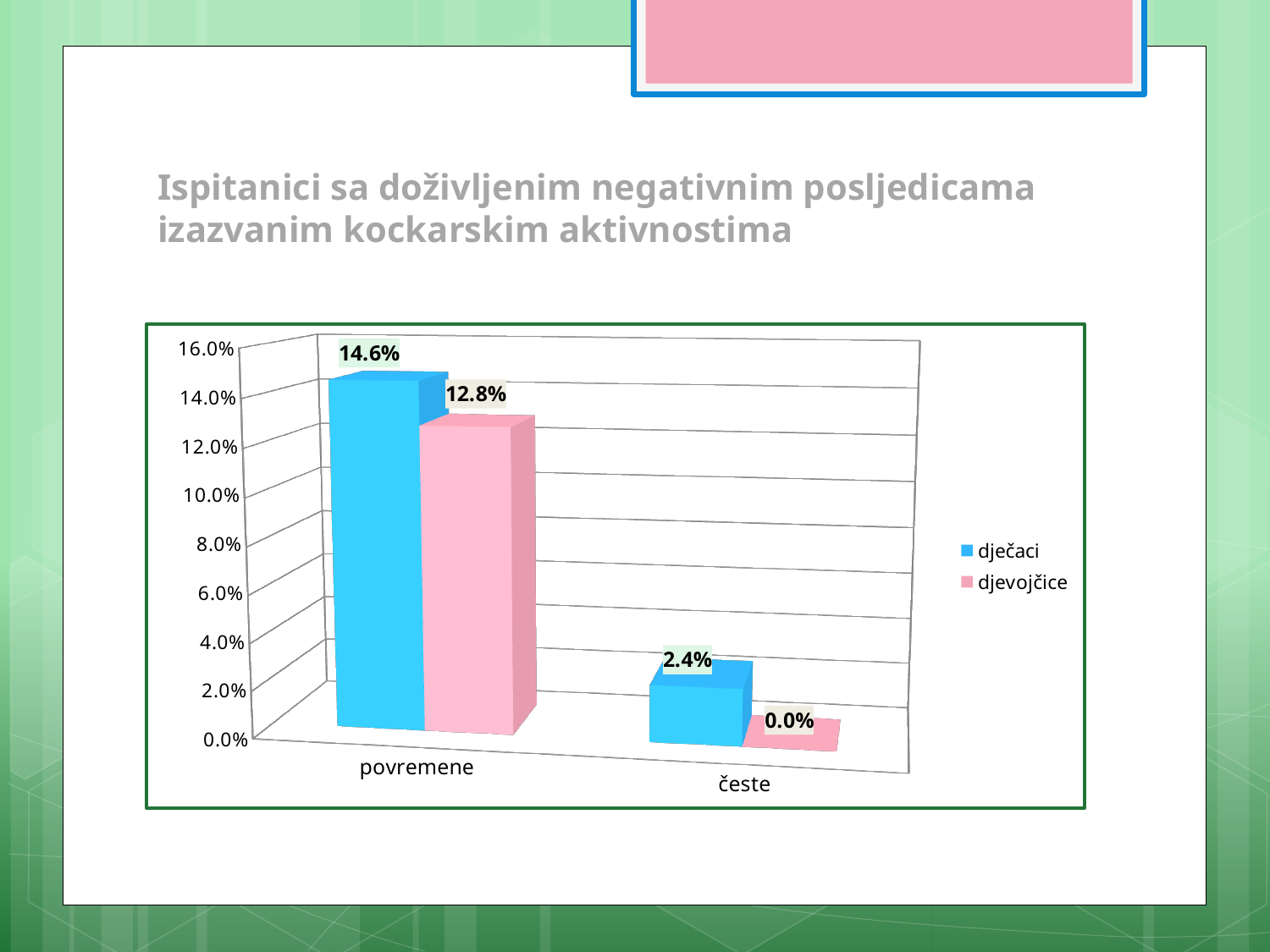
Which category has the lowest value for djevojčice? česte What is the value for djevojčice in the česte category? 0.0% What is the value for dječaci in the povremene category? 14.6% Which category has the highest value for dječaci? povremene How many categories are shown on the x axis? 2 How many series does the legend list? 2 Which is larger in the povremene category, dječaci or djevojčice? dječaci What is the difference between dječaci and djevojčice in the česte category? 2.4% What is the difference between dječaci and djevojčice in the povremene category? 1.8% What is the value for djevojčice in the povremene category? 12.8% What is the value for dječaci in the česte category? 2.4% What kind of chart is shown on the slide? bar chart